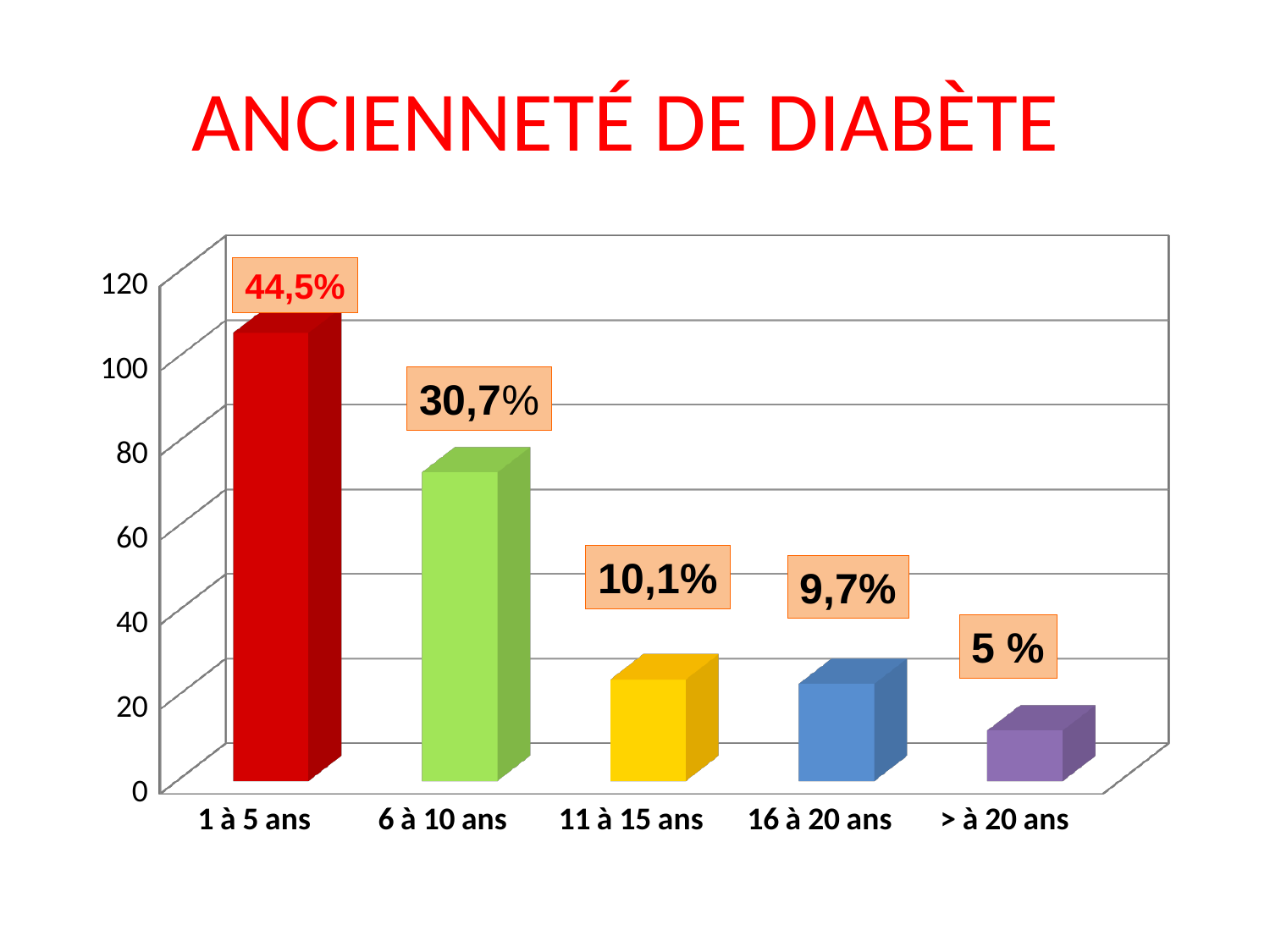
What percentage is shown for the 6 à 10 ans category? 30,7% What percentage is shown for the 1 à 5 ans category? 44,5% What is the difference between the percentages for 1 à 5 ans and 6 à 10 ans? 13,8% Is the bar for > à 20 ans greater or less than 20 on the vertical axis? less Is the bar for 1 à 5 ans greater or less than 100 on the vertical axis? greater Which category has the highest value? 1 à 5 ans Which has the larger percentage label, 11 à 15 ans or 16 à 20 ans? 11 à 15 ans How many categories are shown on the x axis? 5 Which category has the lowest value? > à 20 ans What percentage is shown for the 16 à 20 ans category? 9,7% What percentage is shown for the > à 20 ans category? 5 % Do the values rise or fall from left to right along the x axis? fall